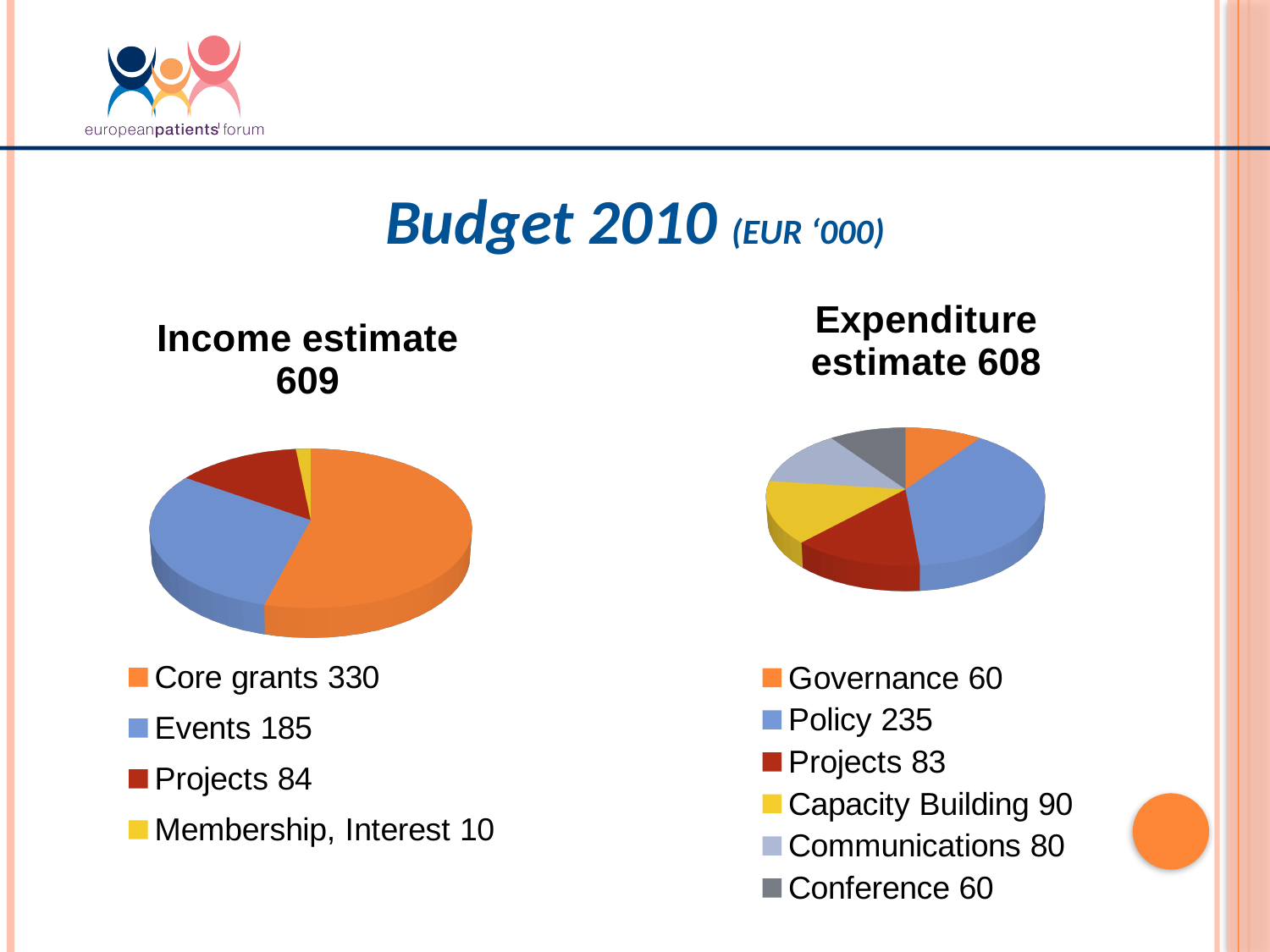
In the Expenditure estimate chart, what is the value for Capacity Building? 90 In the Income estimate chart, which category has the smallest value? Membership, Interest In the Expenditure estimate chart, which is larger, Communications or Capacity Building? Capacity Building How many categories does the Income estimate chart show? 4 How many categories does the Expenditure estimate chart show? 6 In the Expenditure estimate chart, what is the difference between Policy and Projects? 152 In the Income estimate chart, what is the difference between Core grants and Events? 145 In the Income estimate chart, which category has the largest value? Core grants What type of chart is the Income estimate chart? Pie chart What is the total of the Expenditure estimate chart as stated in its title? 608 In the Income estimate chart, what is the value for Core grants? 330 In the Expenditure estimate chart, which category has the largest value? Policy